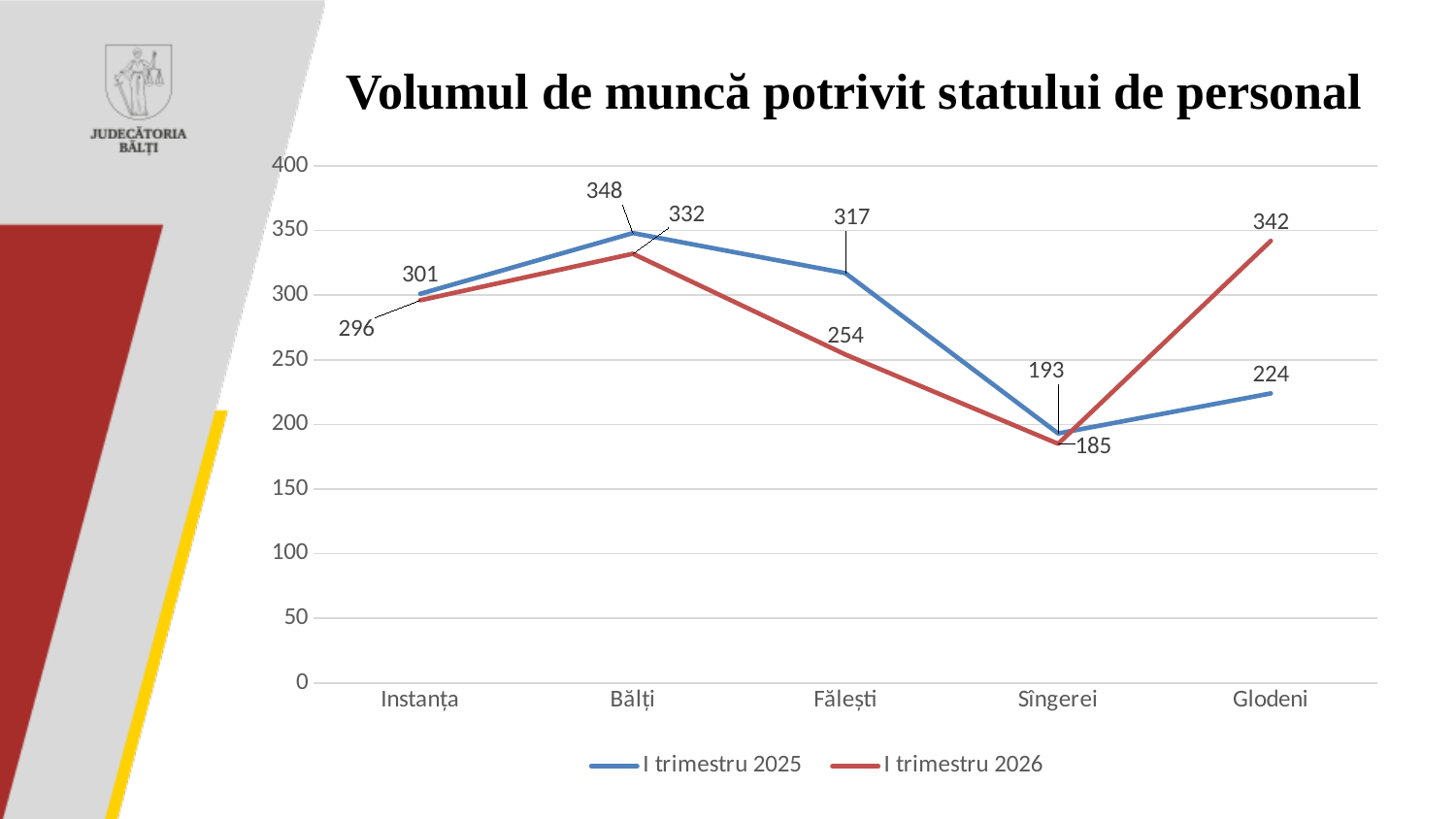
For Glodeni, which series has the larger value, I trimestru 2025 or I trimestru 2026? I trimestru 2026 What kind of chart is shown on the slide? line chart Is the value for Sîngerei in the I trimestru 2026 series greater or less than 200? less What is the title of the chart? Volumul de muncă potrivit statului de personal Which category has the lowest value in the I trimestru 2025 series? Sîngerei What is the value for Bălți in the I trimestru 2025 series? 348 Which category has the highest value in the I trimestru 2026 series? Glodeni What is the value for Fălești in the I trimestru 2026 series? 254 What is the value for Glodeni in the I trimestru 2026 series? 342 How many categories are shown on the x axis? 5 What is the difference between the I trimestru 2025 and I trimestru 2026 values for Fălești? 63 How many series does the legend list? 2